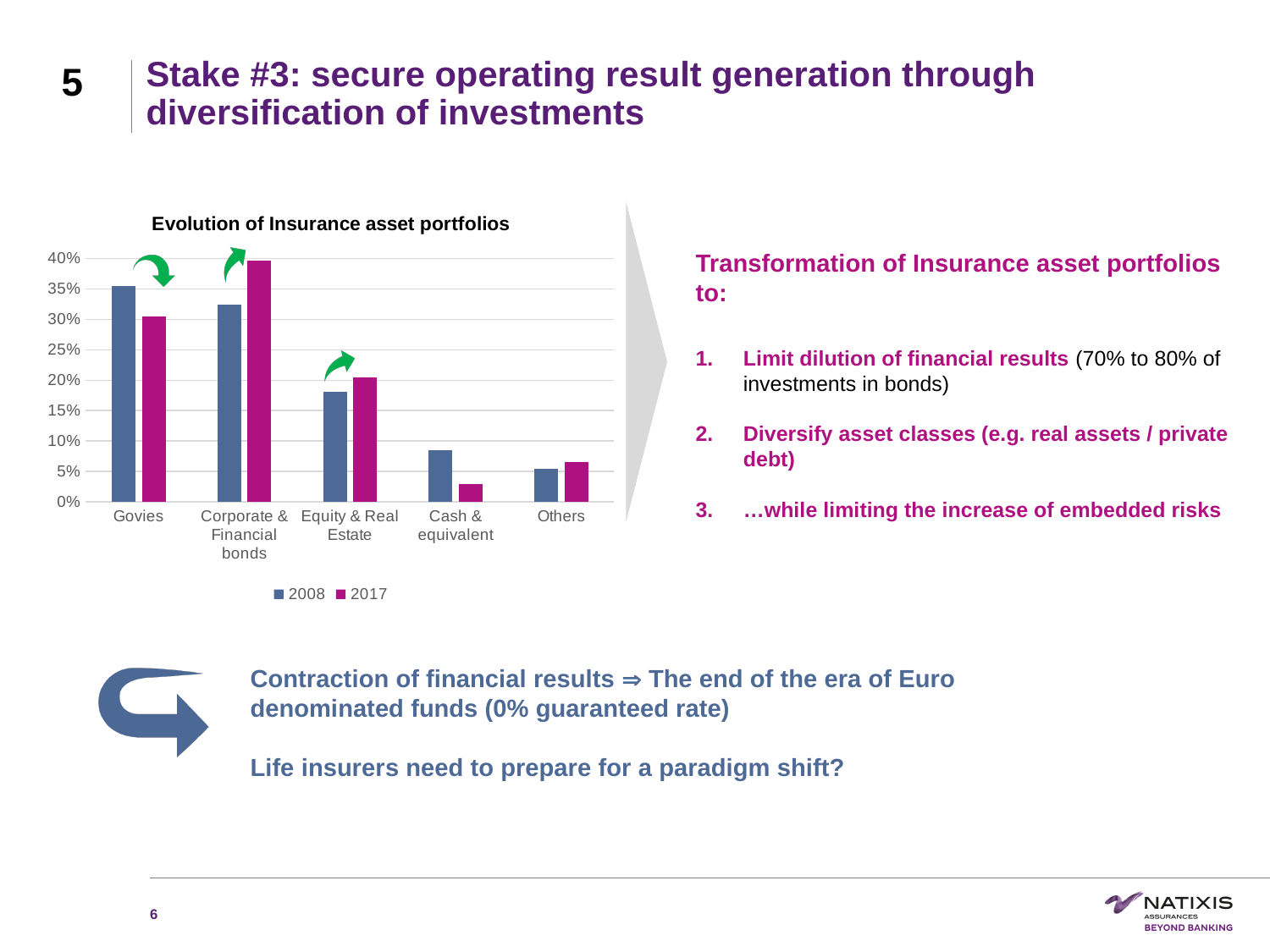
Is the 2017 value for Corporate & Financial bonds greater or less than 35%? greater How many asset categories are shown on the x axis of the chart? 5 Which category has the highest value for 2017? Corporate & Financial bonds For Govies, which year has the larger value, 2008 or 2017? 2008 How many series does the chart legend list? 2 What kind of chart is shown on the slide? bar chart For Corporate & Financial bonds, which year has the larger value, 2008 or 2017? 2017 Is the 2008 value for Cash & equivalent greater or less than 10%? less What is the title of the chart? Evolution of Insurance asset portfolios Which category has the lowest value for 2017? Cash & equivalent Is the 2017 value for Equity & Real Estate greater or less than 15%? greater Which category has the highest value for 2008? Govies